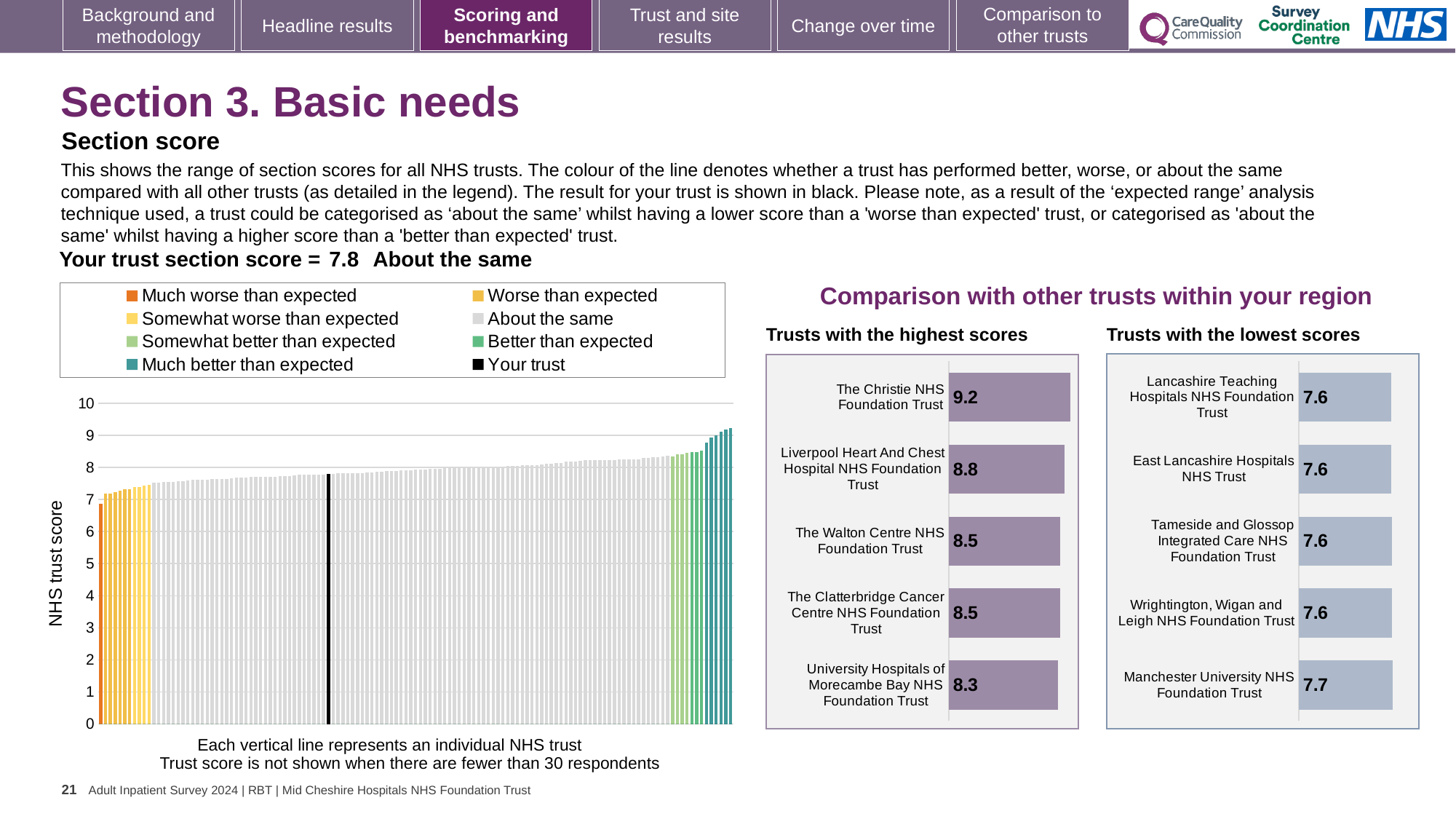
How many trusts are shown in the 'Trusts with the lowest scores' chart? 5 In the 'Trusts with the highest scores' chart, which trust has the lowest score? University Hospitals of Morecambe Bay NHS Foundation Trust In the large chart on the left, what is the section score for your trust (the black bar)? 7.8 In the 'Trusts with the lowest scores' chart, which trust has the highest score? Manchester University NHS Foundation Trust In the large chart on the left, is the value of the tallest bar greater or less than 9? greater In the large chart on the left, do the bar heights rise or fall from left to right? rise In the large chart on the left, how many entries does the legend list? 8 In the 'Trusts with the highest scores' chart, which has the higher score: Liverpool Heart And Chest Hospital NHS Foundation Trust or The Walton Centre NHS Foundation Trust? Liverpool Heart And Chest Hospital NHS Foundation Trust In the large chart on the left, what is the label of the vertical axis? NHS trust score In the 'Trusts with the highest scores' chart, what is the score for The Christie NHS Foundation Trust? 9.2 In the 'Trusts with the highest scores' chart, what is the difference between the scores of The Christie NHS Foundation Trust and University Hospitals of Morecambe Bay NHS Foundation Trust? 0.9 What kind of chart is the large chart on the left showing the range of section scores for all NHS trusts? bar chart